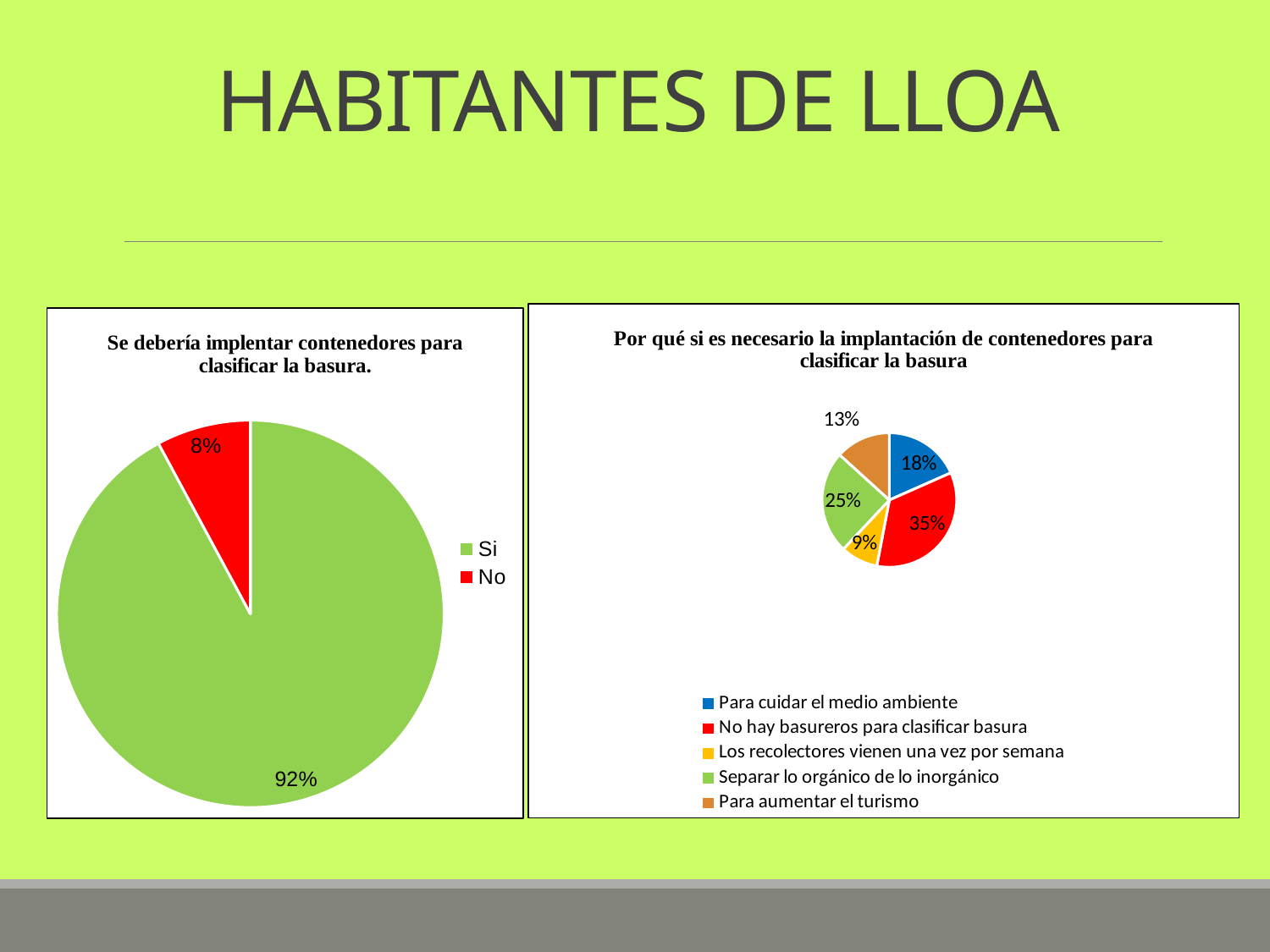
In the right chart titled "Por qué si es necesario la implantación de contenedores para clasificar la basura", which category has the smallest share? Los recolectores vienen una vez por semana In the right chart titled "Por qué si es necesario la implantación de contenedores para clasificar la basura", which is larger: "Separar lo orgánico de lo inorgánico" or "Para aumentar el turismo"? Separar lo orgánico de lo inorgánico In the right chart titled "Por qué si es necesario la implantación de contenedores para clasificar la basura", what share is "No hay basureros para clasificar basura"? 35% In the left chart titled "Se debería implantar contenedores para clasificar la basura.", what share of the pie is "Si"? 92% In the left chart titled "Se debería implantar contenedores para clasificar la basura.", what is the difference between the "Si" and "No" shares? 84% How many categories does the legend of the left chart titled "Se debería implantar contenedores para clasificar la basura." list? 2 In the right chart titled "Por qué si es necesario la implantación de contenedores para clasificar la basura", which category has the largest share? No hay basureros para clasificar basura In the left chart titled "Se debería implantar contenedores para clasificar la basura.", what share of the pie is "No"? 8% In the right chart titled "Por qué si es necesario la implantación de contenedores para clasificar la basura", what colour is the slice for "Para aumentar el turismo"? Orange How many categories does the legend of the right chart titled "Por qué si es necesario la implantación de contenedores para clasificar la basura" list? 5 What kind of chart is the left chart titled "Se debería implantar contenedores para clasificar la basura."? Pie chart